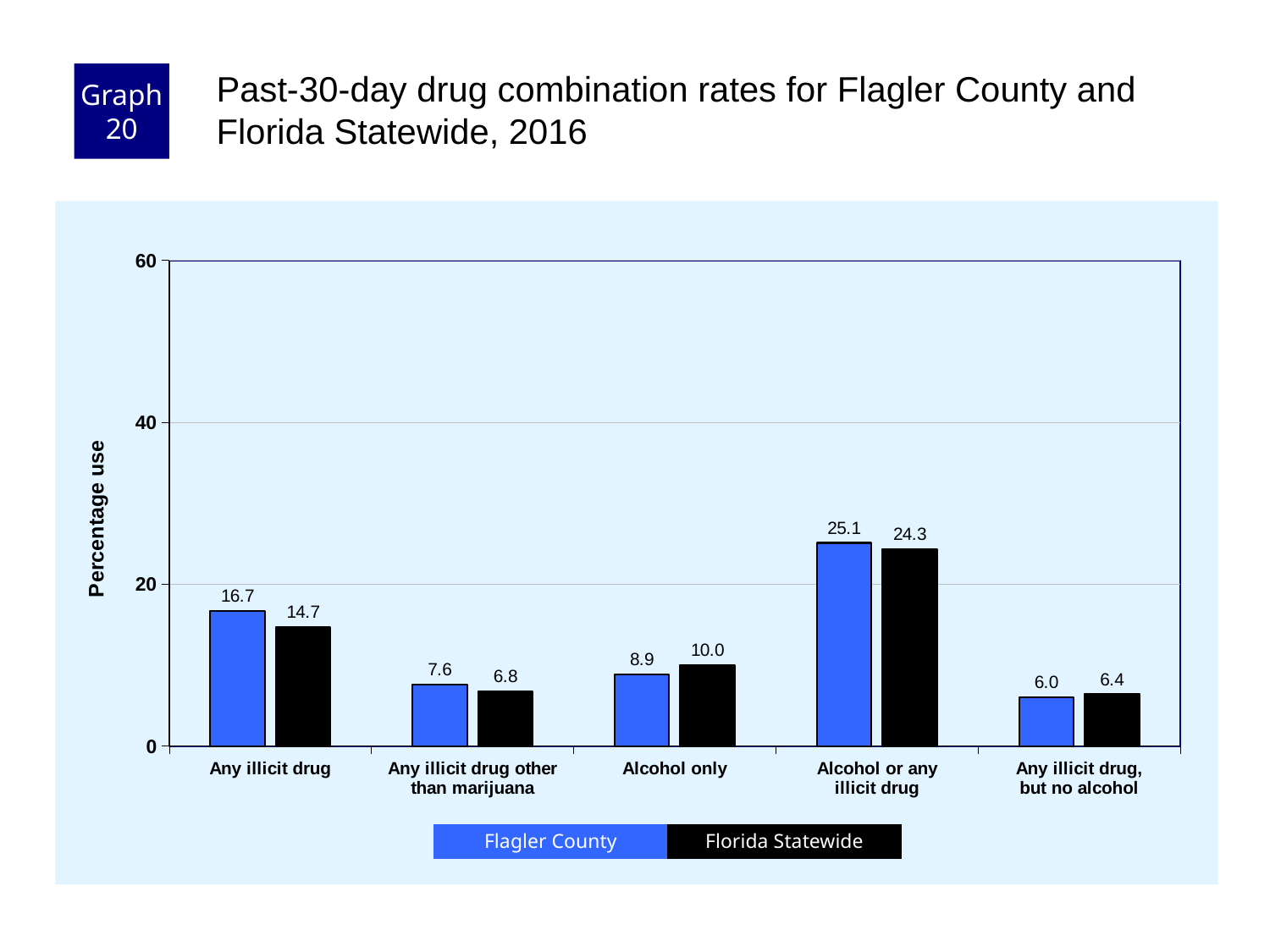
What is the Flagler County value for Any illicit drug? 16.7 Which category has the highest Flagler County value? Alcohol or any illicit drug What is the label of the y axis? Percentage use What is the difference between the Flagler County and Florida Statewide values for Any illicit drug? 2.0 What is the Florida Statewide value for Alcohol only? 10.0 Which is larger for Alcohol only: Flagler County or Florida Statewide? Florida Statewide How many series does the legend list? 2 What kind of chart is shown on the slide? Bar chart What is the Florida Statewide value for Any illicit drug, but no alcohol? 6.4 How many categories are shown on the x axis? 5 Is the Flagler County value for Alcohol or any illicit drug greater or less than 20? greater Which category has the lowest Florida Statewide value? Any illicit drug, but no alcohol